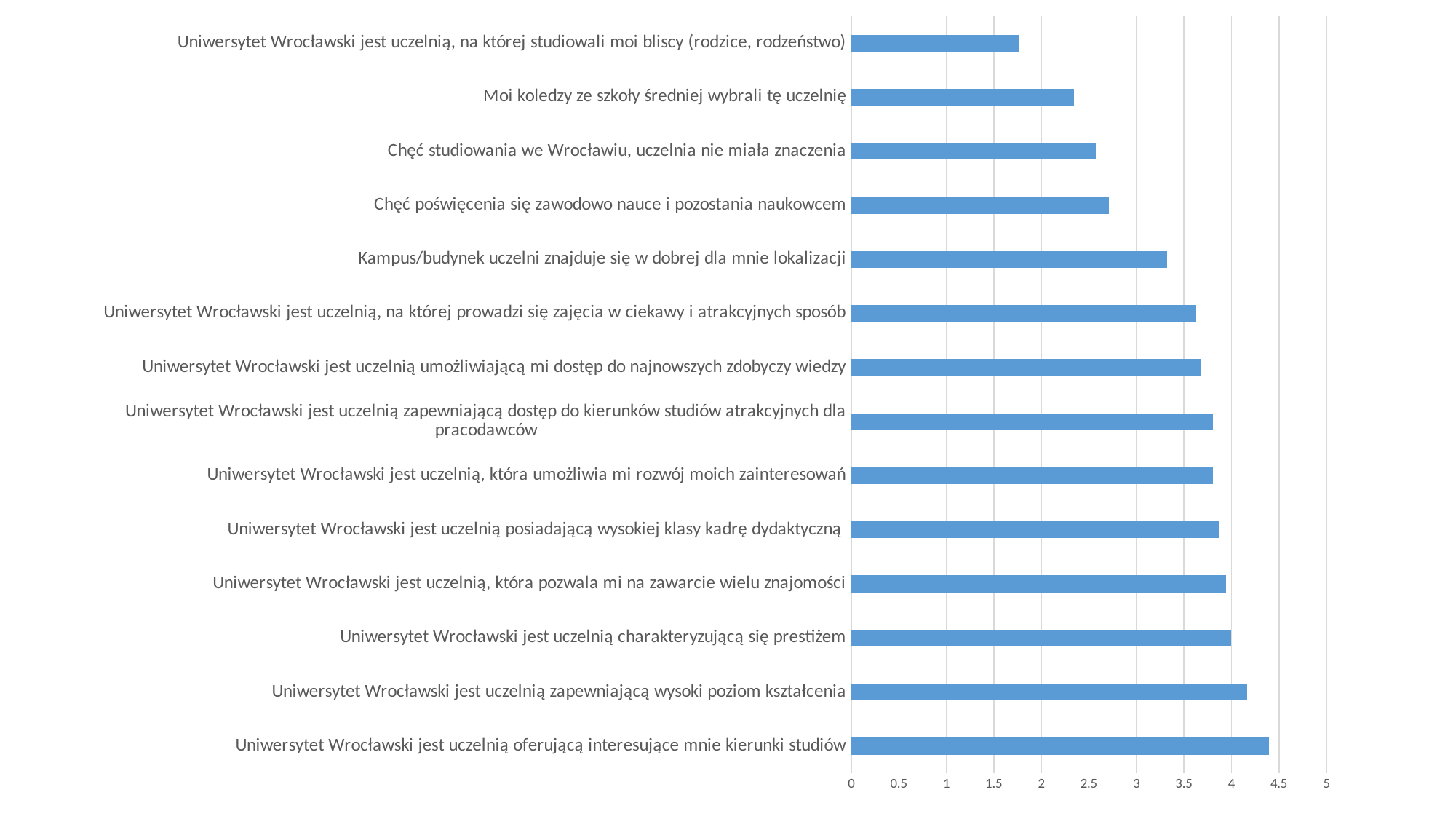
Is the value for "Uniwersytet Wrocławski jest uczelnią, na której studiowali moi bliscy (rodzice, rodzeństwo)" greater or less than 2? less Which statement has the highest value in the chart? Uniwersytet Wrocławski jest uczelnią oferującą interesujące mnie kierunki studiów Is the value for "Chęć poświęcenia się zawodowo nauce i pozostania naukowcem" greater or less than 3? less Is the value for "Kampus/budynek uczelni znajduje się w dobrej dla mnie lokalizacji" greater or less than 3? greater What kind of chart is shown on the slide? bar chart Which has a larger value: "Uniwersytet Wrocławski jest uczelnią zapewniającą wysoki poziom kształcenia" or "Kampus/budynek uczelni znajduje się w dobrej dla mnie lokalizacji"? Uniwersytet Wrocławski jest uczelnią zapewniającą wysoki poziom kształcenia How many categories (statements) are plotted in the chart? 14 Which statement has the lowest value in the chart? Uniwersytet Wrocławski jest uczelnią, na której studiowali moi bliscy (rodzice, rodzeństwo) What is the maximum value shown on the horizontal axis of the chart? 5 Which has a larger value: "Moi koledzy ze szkoły średniej wybrali tę uczelnię" or "Chęć studiowania we Wrocławiu, uczelnia nie miała znaczenia"? Chęć studiowania we Wrocławiu, uczelnia nie miała znaczenia